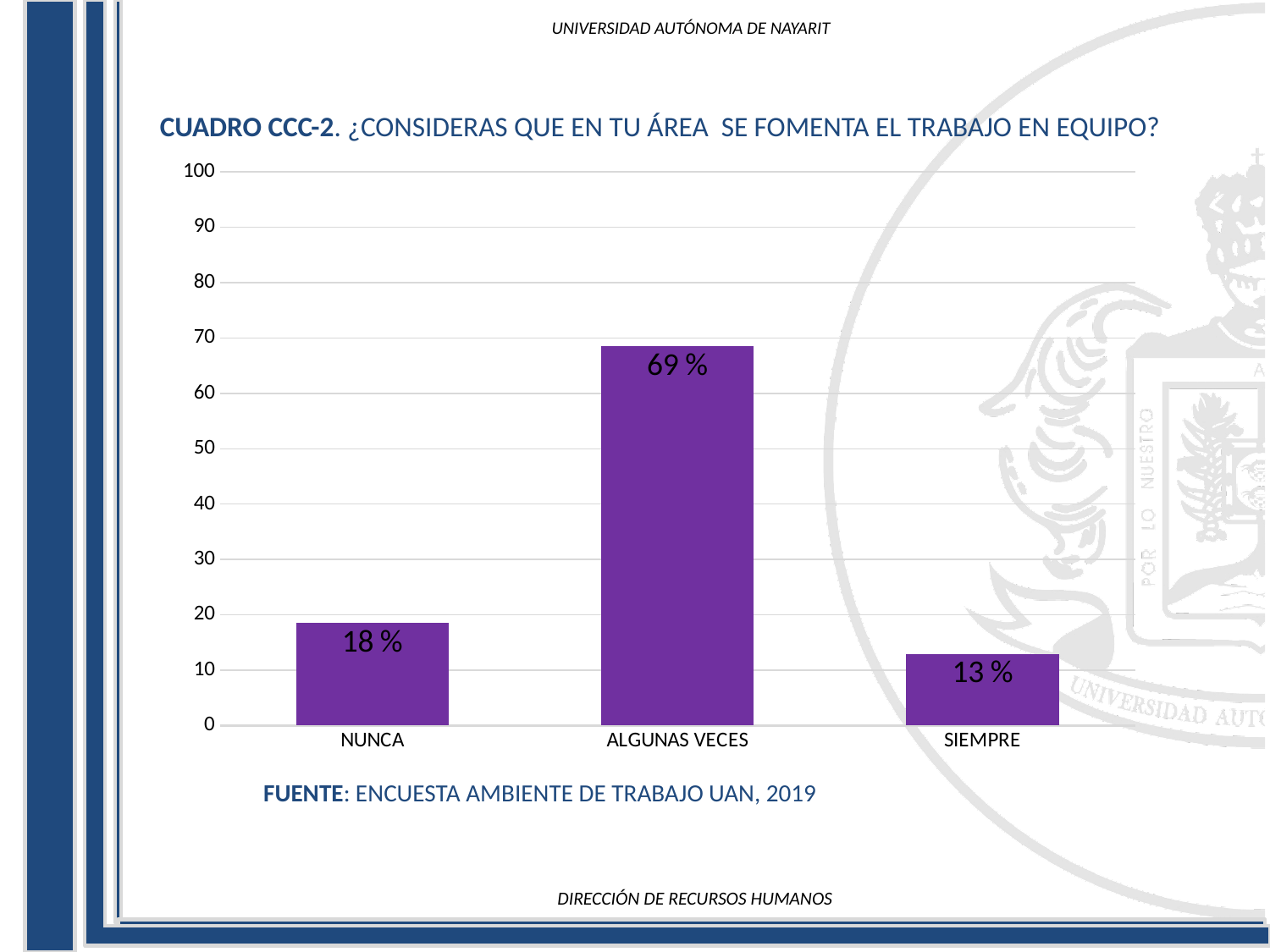
What is the value for SIEMPRE? 13 % What is the source cited below the chart? ENCUESTA AMBIENTE DE TRABAJO UAN, 2019 What is the difference between the values for ALGUNAS VECES and NUNCA? 51 % Is the value for ALGUNAS VECES greater or less than 60? greater Which category has the lowest value? SIEMPRE What kind of chart is shown on the slide? bar chart What is the value for NUNCA? 18 % How many categories are shown on the x axis? 3 Which category has the highest value? ALGUNAS VECES What is the difference between the values for NUNCA and SIEMPRE? 5 % What is the value for ALGUNAS VECES? 69 % Which is larger, the value for NUNCA or the value for SIEMPRE? NUNCA